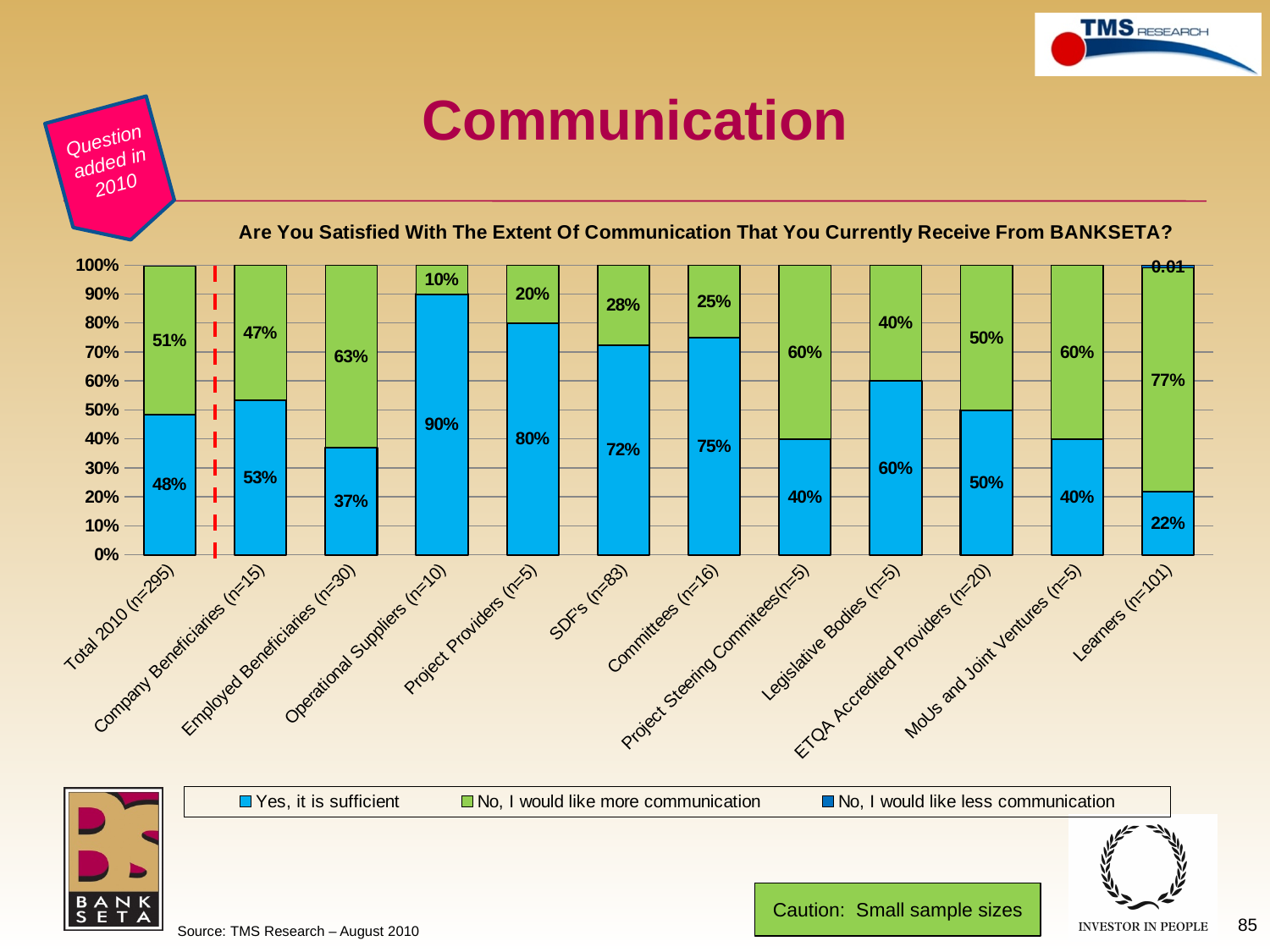
Which category has the lowest 'Yes, it is sufficient' value? Learners (n=101) What is the difference between the 'Yes, it is sufficient' values for Project Providers (n=5) and Employed Beneficiaries (n=30)? 43% Which has a larger 'Yes, it is sufficient' value: Committees (n=16) or SDF's (n=83)? Committees (n=16) How many series does the legend list? 3 What is the title of the chart? Are You Satisfied With The Extent Of Communication That You Currently Receive From BANKSETA? How many categories are shown along the x axis? 12 What type of chart is shown on the slide? Stacked bar chart Which category has the highest 'Yes, it is sufficient' value? Operational Suppliers (n=10) What percentage of Learners (n=101) answered 'No, I would like more communication'? 77% What is the 'Yes, it is sufficient' value for Total 2010 (n=295)? 48% What percentage of Operational Suppliers (n=10) answered 'Yes, it is sufficient'? 90% Which category has the lowest 'No, I would like more communication' value? Operational Suppliers (n=10)